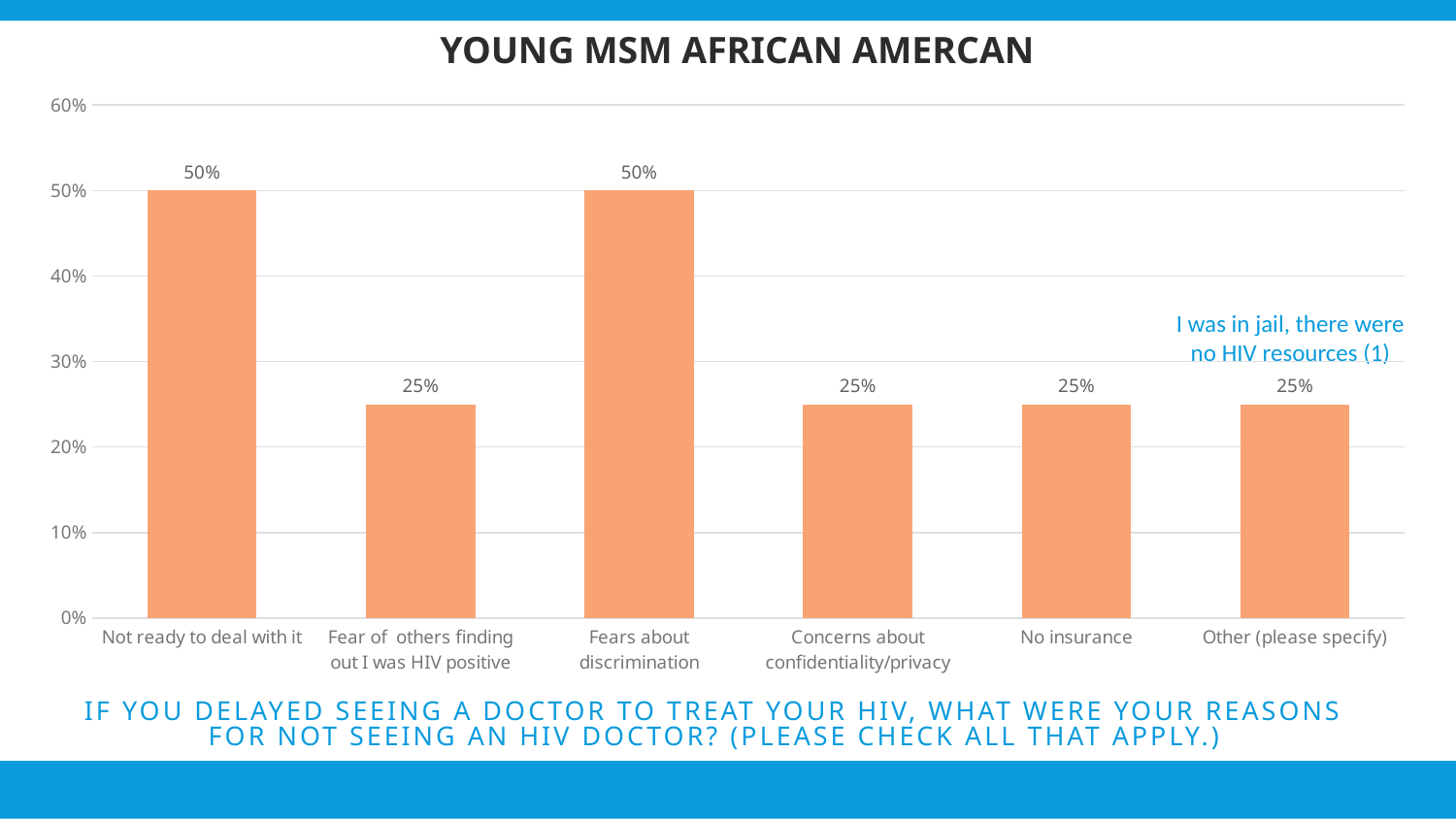
Which is larger, the value for "Fears about discrimination" or the value for "No insurance"? Fears about discrimination Is the value for "Not ready to deal with it" greater or less than 40%? greater What is the value for "Not ready to deal with it"? 50% Is the value for "No insurance" greater or less than 30%? less What is the value for "No insurance"? 25% What kind of chart is shown on the slide? Bar chart How many categories are shown on the x axis of the chart? 6 What is the value for "Fears about discrimination"? 50% What is the value for "Concerns about confidentiality/privacy"? 25% What text is written in the annotation above the "Other (please specify)" bar? I was in jail, there were no HIV resources (1) What is the difference between the values for "Not ready to deal with it" and "Fear of others finding out I was HIV positive"? 25% What is the value for "Other (please specify)"? 25%